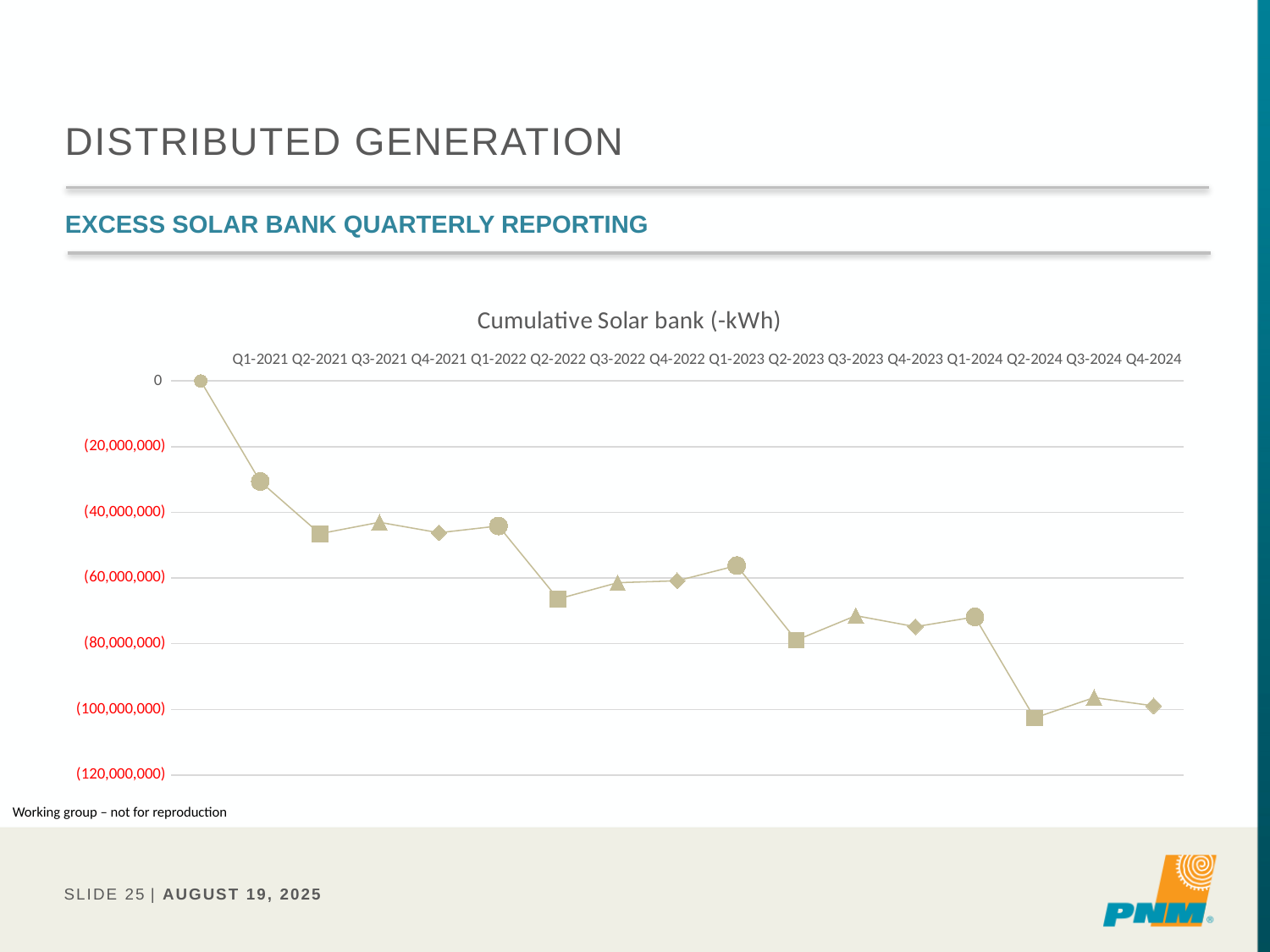
What is the lowest value labelled on the y axis? (120,000,000) Is the value for Q2-2023 greater or less than (60,000,000)? less Is the value for Q2-2021 greater or less than (20,000,000)? less What is the title of the chart? Cumulative Solar bank (-kWh) Which is larger, the value for Q2-2021 or the value for Q3-2021? Q3-2021 Is the value for Q3-2024 greater or less than (100,000,000)? greater Do the values generally rise or fall from Q1-2021 to Q4-2024? fall Which quarter has the highest value on the chart? Q1-2021 How many quarters are plotted on the x axis of the chart? 16 Which quarter has the lowest value on the chart? Q2-2024 What kind of chart is shown on the slide? line chart